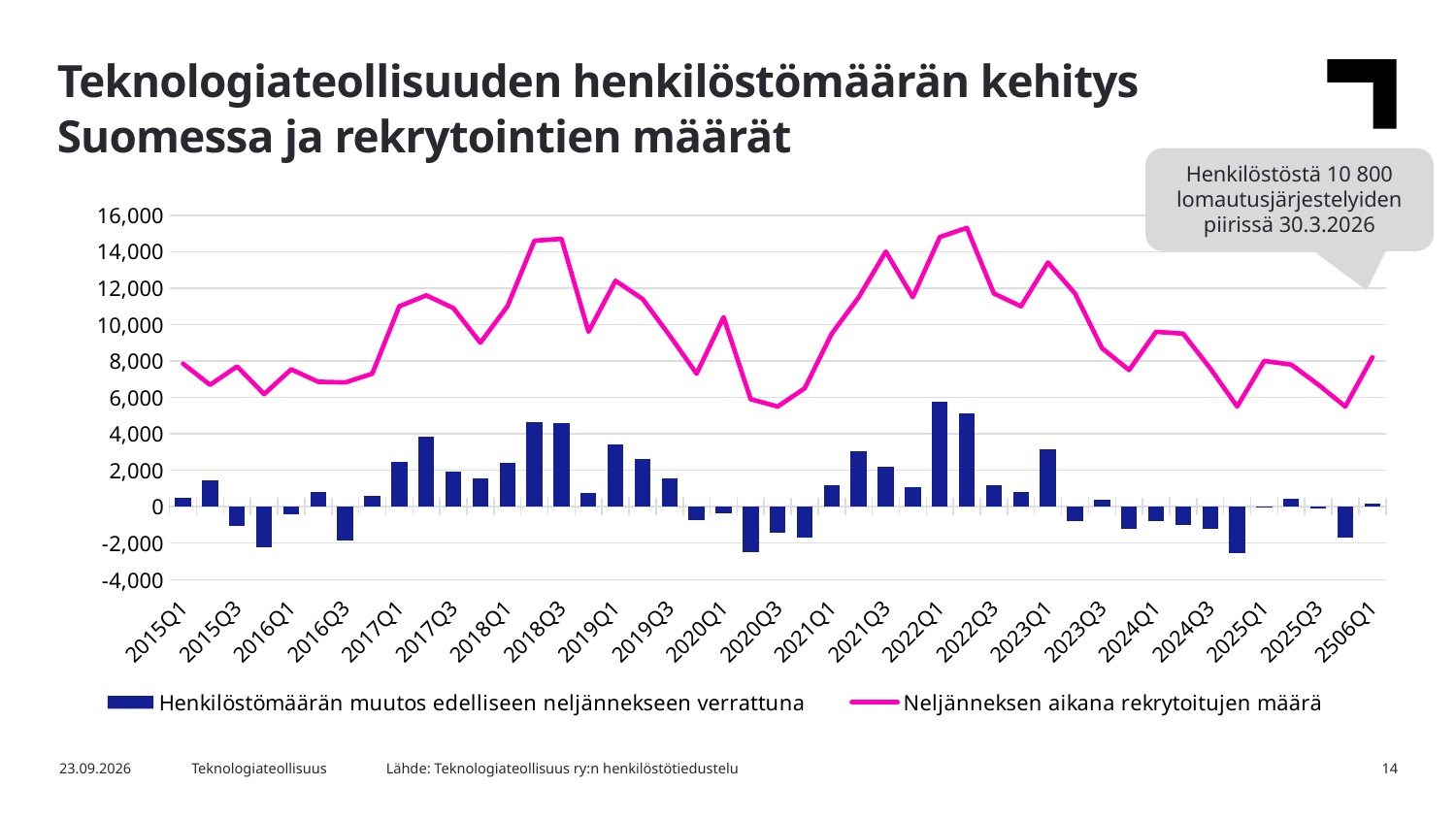
Which series is drawn as bars in the chart? Henkilöstömäärän muutos edelliseen neljännekseen verrattuna Is the value of the recruitment line (Neljänneksen aikana rekrytoitujen määrä) at 2025Q3 greater or less than 8,000? less Which series is drawn as a line in the chart? Neljänneksen aikana rekrytoitujen määrä What is the highest value shown on the vertical axis? 16,000 Is the value of the recruitment line (Neljänneksen aikana rekrytoitujen määrä) at 2020Q3 greater or less than 8,000? less What kind of chart is shown on the slide? A combination bar and line chart Is the value of the recruitment line (Neljänneksen aikana rekrytoitujen määrä) at 2018Q3 greater or less than 12,000? greater How many series does the chart legend list? 2 How many category labels are shown on the x axis? 23 In which year does the recruitment line (Neljänneksen aikana rekrytoitujen määrä) reach its highest point? 2022 Does the recruitment line (Neljänneksen aikana rekrytoitujen määrä) generally rise or fall between 2022Q1 and 2025Q3? fall